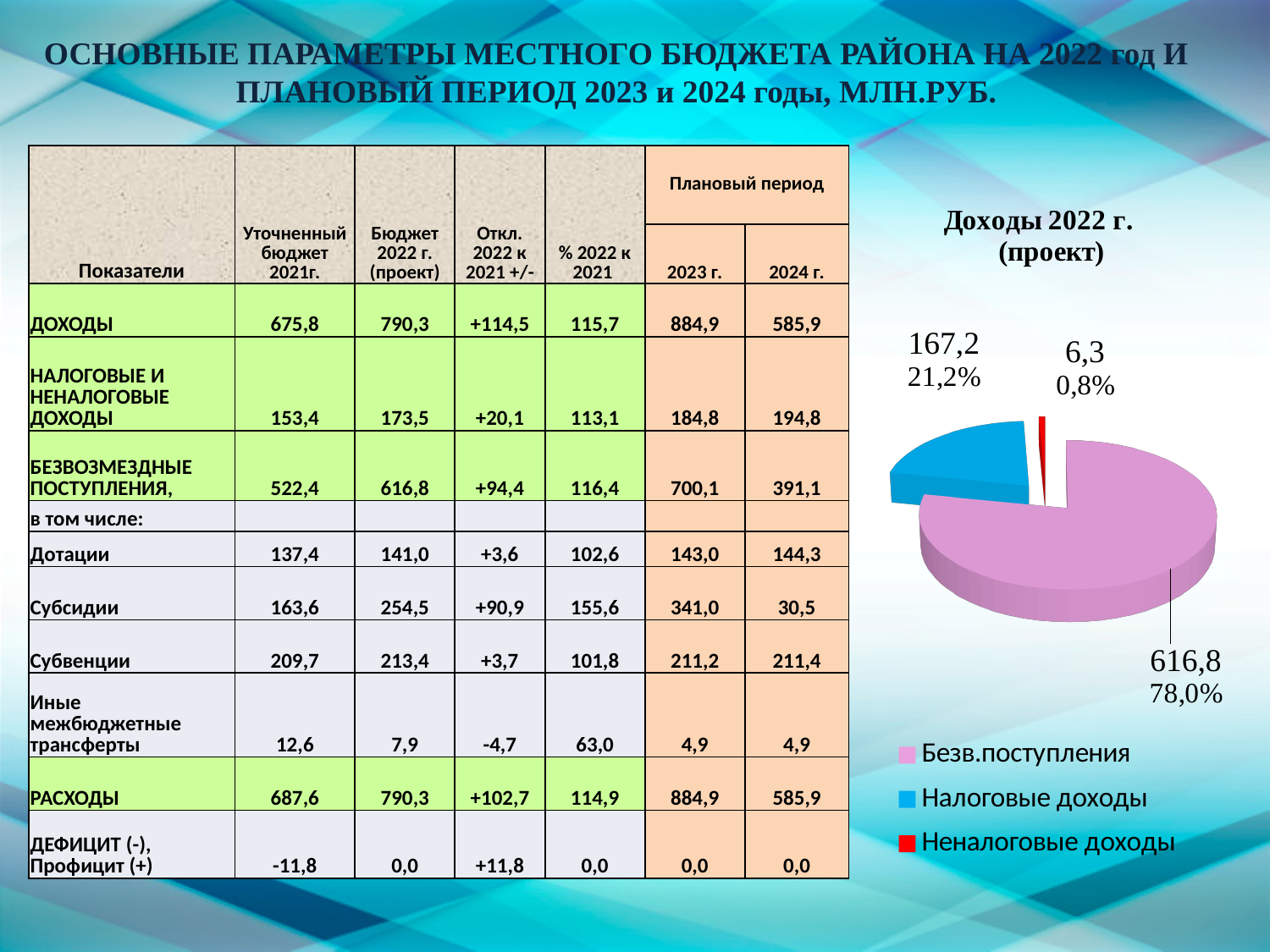
What share of the pie does Безв.поступления represent? 78,0% How many entries does the pie chart legend list? 3 In the pie chart, what is the difference between the values for Налоговые доходы and Неналоговые доходы? 160,9 What is the value shown for Безв.поступления in the pie chart? 616,8 What share of the pie does Налоговые доходы represent? 21,2% What is the value shown for Налоговые доходы in the pie chart? 167,2 What is the title of the pie chart? Доходы 2022 г. (проект) What kind of chart is shown on the right side of the slide? Pie chart How many slices does the pie chart have? 3 What is the value shown for Неналоговые доходы in the pie chart? 6,3 Which slice of the pie chart is the smallest? Неналоговые доходы Which slice of the pie chart is the largest? Безв.поступления